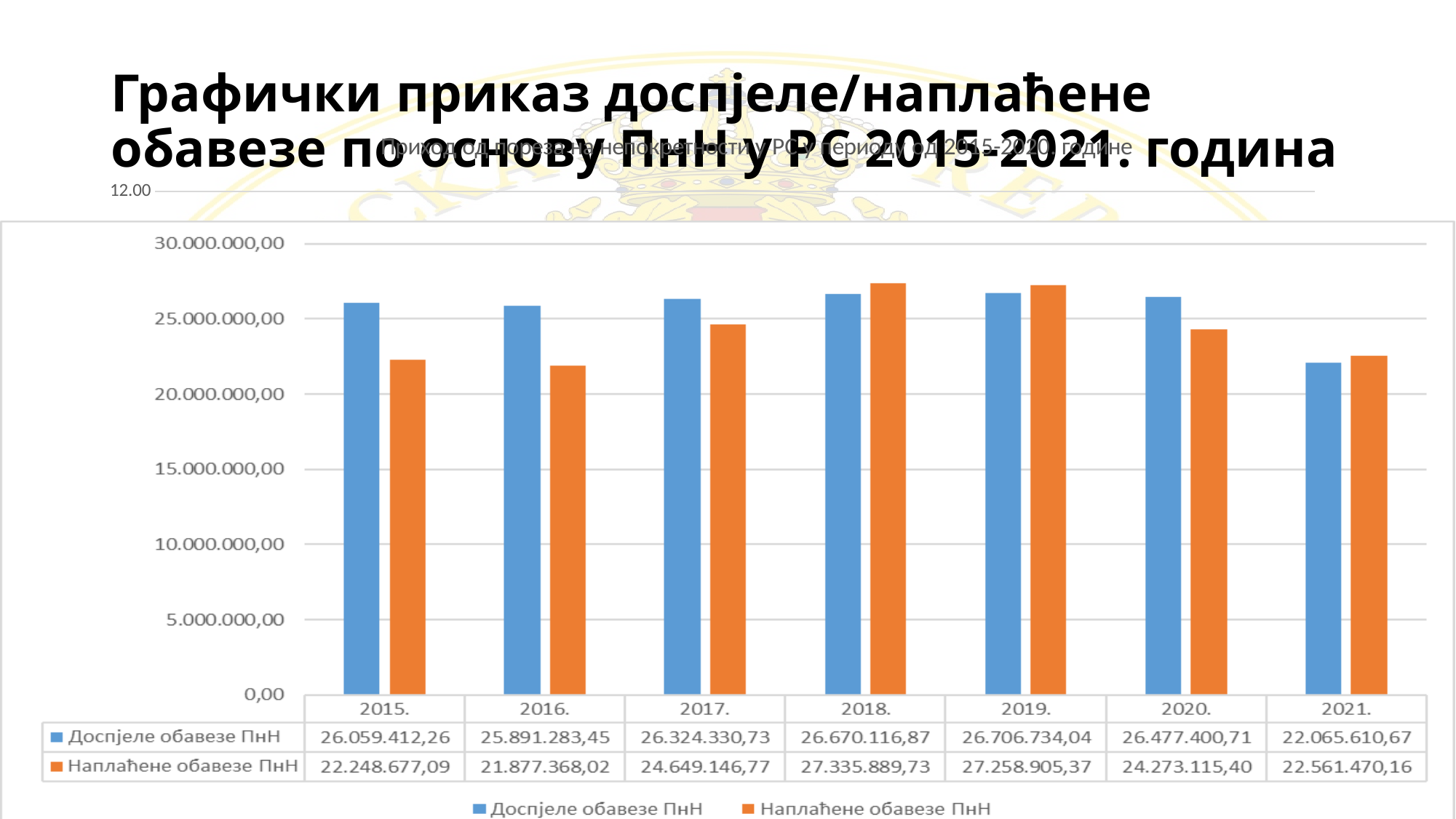
In which year is Доспјеле обавезе ПнН the lowest? 2021. In which year is Наплаћене обавезе ПнН the highest? 2018. What is the value of Доспјеле обавезе ПнН for 2015.? 26.059.412,26 What is the value of Наплаћене обавезе ПнН for 2020.? 24.273.115,40 How many years are shown on the x axis of the chart? 7 What is the difference between Доспјеле обавезе ПнН and Наплаћене обавезе ПнН in 2015.? 3.810.735,17 In which year is Наплаћене обавезе ПнН the lowest? 2016. How many series does the legend list? 2 What kind of chart is shown on the slide? bar chart What is the value of Наплаћене обавезе ПнН for 2017.? 24.649.146,77 In 2018., which is larger: Доспјеле обавезе ПнН or Наплаћене обавезе ПнН? Наплаћене обавезе ПнН Is the value of Доспјеле обавезе ПнН for 2021. greater or less than 25.000.000,00? less